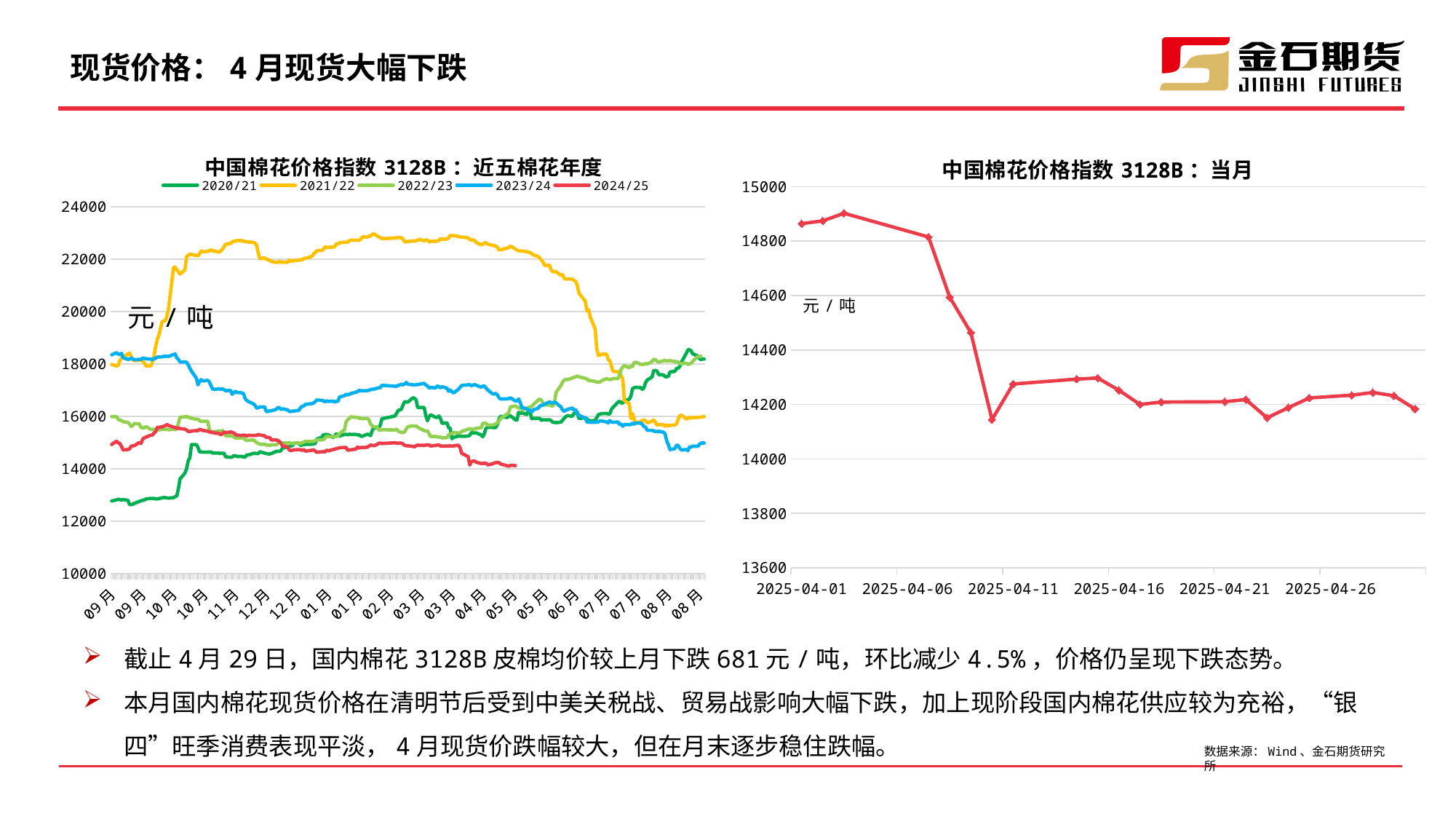
In the left chart (近五棉花年度), which series reaches the highest level on the chart? 2021/22 In the left chart (近五棉花年度), which series has the lowest value at the start of the x axis (09月)? 2020/21 What kind of chart is the left chart titled 中国棉花价格指数 3128B：近五棉花年度? line chart How many series does the legend of the left chart (近五棉花年度) list? 5 In the left chart (近五棉花年度), is the last plotted value of the 2024/25 series greater or less than 15000? less In the left chart (近五棉花年度), is the peak value of the 2021/22 series greater or less than 22000? greater In the left chart (近五棉花年度), which series is drawn in yellow? 2021/22 In the right chart (当月), do the values overall rise or fall from 2025-04-01 to the end of the month? fall What unit is shown on the right chart (当月)? 元/吨 In the left chart (近五棉花年度), is the starting value of the 2020/21 series in 09月 greater or less than 14000? less What kind of chart is the right chart titled 中国棉花价格指数 3128B：当月? line chart